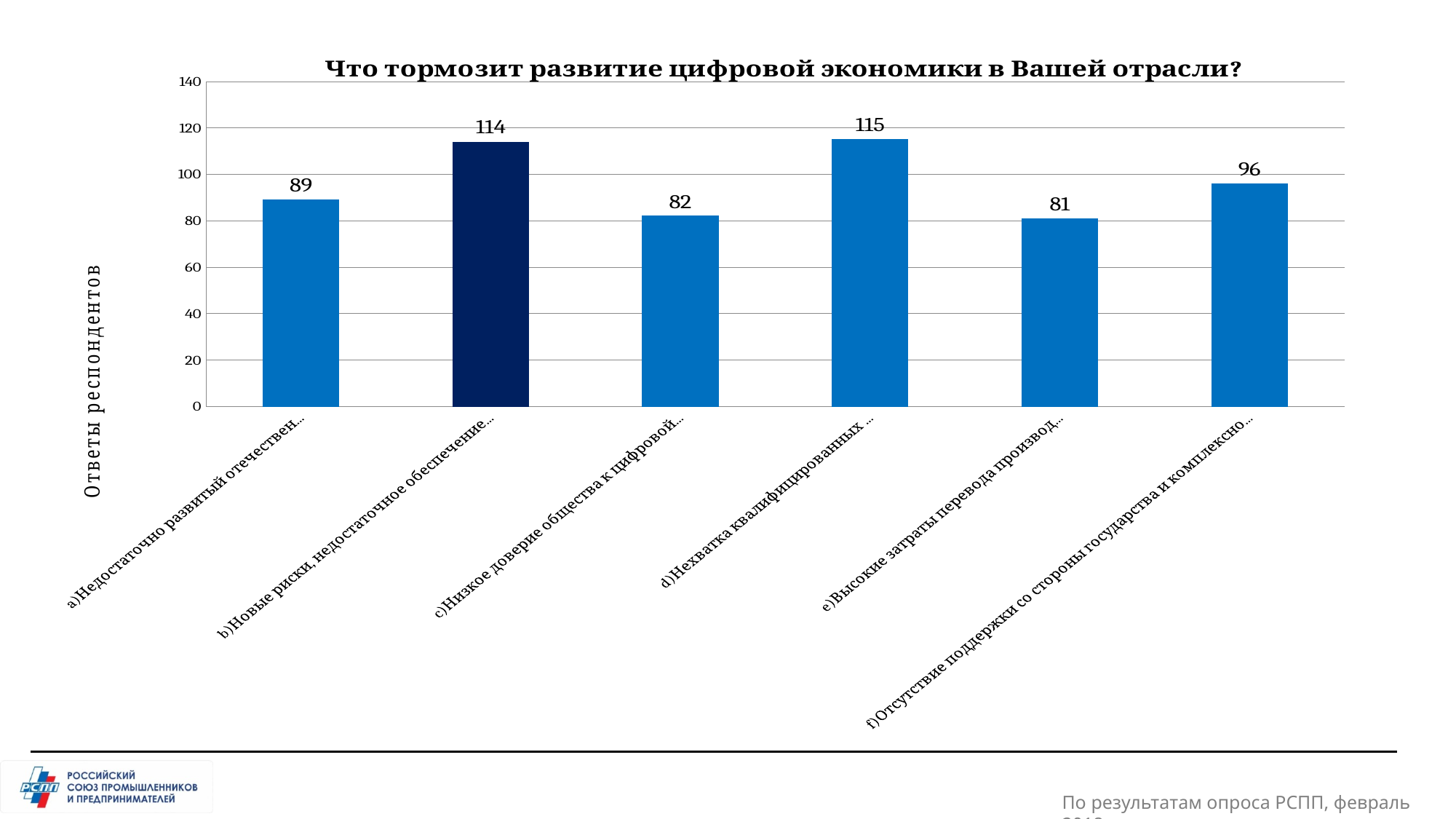
Which category has the highest value? d) Нехватка квалифицированных … Which category has the lowest value? e) Высокие затраты перевода производ… What is the title of the chart? Что тормозит развитие цифровой экономики в Вашей отрасли? What is the value for category d) Нехватка квалифицированных …? 115 What kind of chart is shown on the slide? Bar chart What is the value for category a) Недостаточно развитый отечествен…? 89 How many categories are shown in the chart? 6 What is the label of the vertical axis? Ответы респондентов What is the difference between the values for category d) Нехватка квалифицированных … and category a) Недостаточно развитый отечествен…? 26 What is the value for category b) Новые риски, недостаточное обеспечение…? 114 What is the value for category f) Отсутствие поддержки со стороны государства и комплексно…? 96 Which is larger: the value for category f) Отсутствие поддержки со стороны государства… or the value for category c) Низкое доверие общества к цифровой…? f) Отсутствие поддержки со стороны государства…